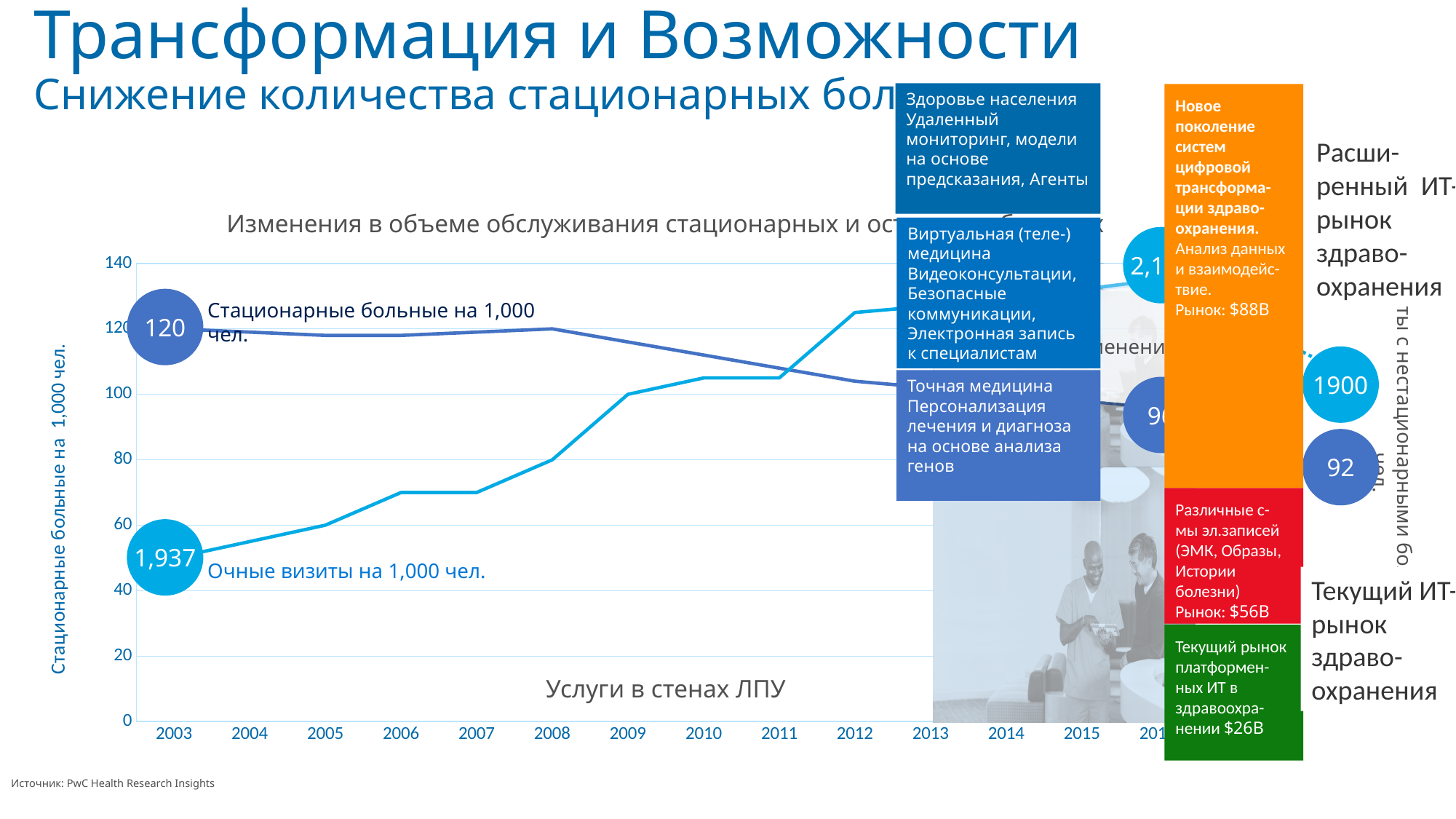
Is the plotted value of the "Очные визиты на 1,000 чел." line in 2008 greater or less than 100? less Does the "Стационарные больные на 1,000 чел." line rise or fall between 2008 and 2013? falls What value is labelled for "Очные визиты на 1,000 чел." at the start of the chart (2003)? 1,937 What kind of chart is shown on the slide? line chart Is the plotted value of the "Стационарные больные на 1,000 чел." line in 2008 greater or less than 100? greater Is the plotted value of the "Очные визиты на 1,000 чел." line in 2012 greater or less than 100? greater How many data series (lines) are plotted on the chart? 2 What value is labelled for "Стационарные больные на 1,000 чел." at the start of the chart (2003)? 120 In 2012, which line is plotted higher on the chart: "Стационарные больные на 1,000 чел." or "Очные визиты на 1,000 чел."? Очные визиты на 1,000 чел. Does the "Очные визиты на 1,000 чел." line rise or fall between 2003 and 2012? rises What is the title of the vertical axis of the chart? Стационарные больные на 1,000 чел.